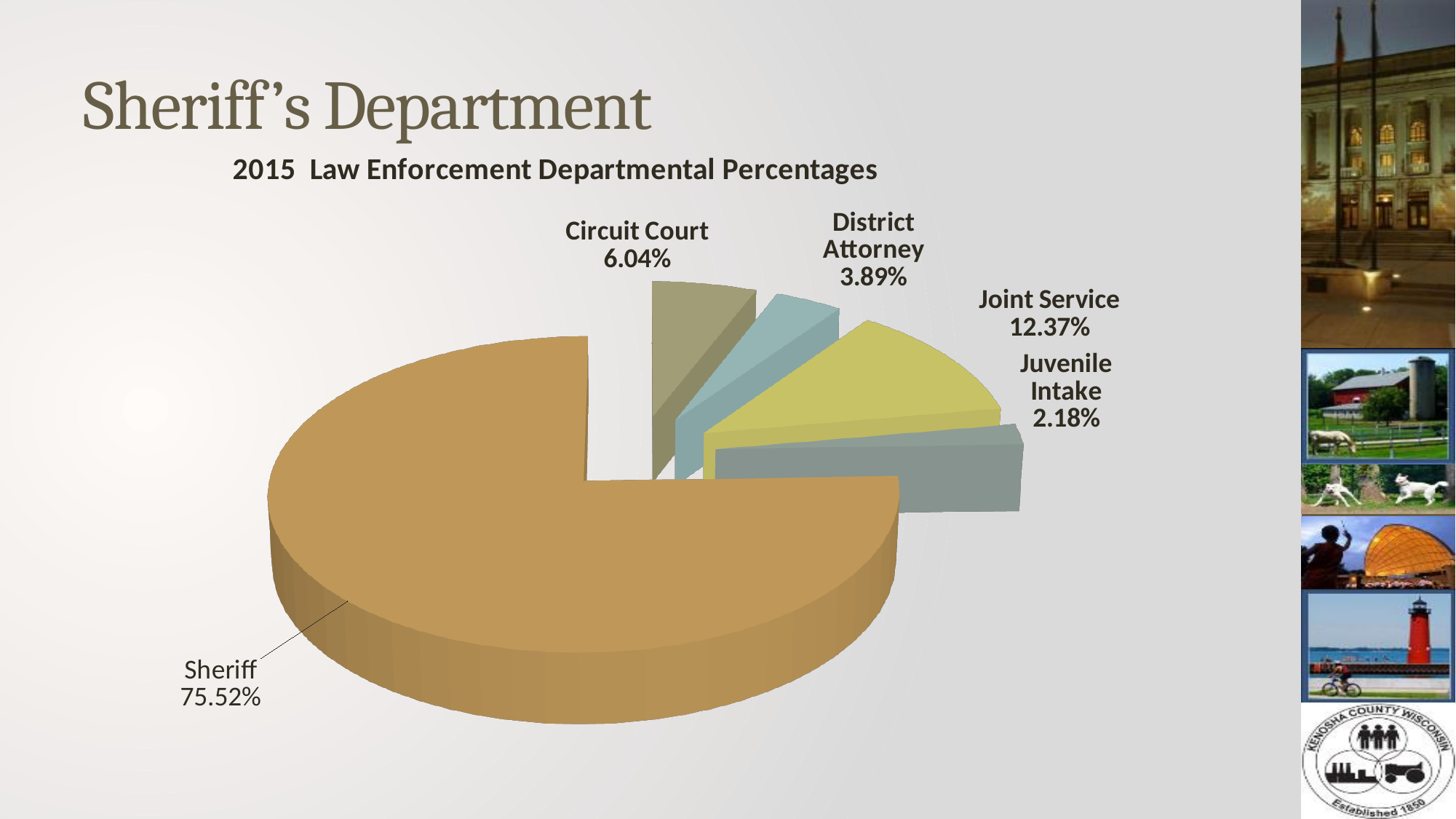
What percentage is shown for Joint Service? 12.37% What percentage is shown for Circuit Court? 6.04% Which is larger, the District Attorney share or the Circuit Court share? Circuit Court How many slices does the pie chart have? 5 What is the difference in percentage points between Joint Service and Circuit Court? 6.33 What is the title of the chart? 2015 Law Enforcement Departmental Percentages Which department has the smallest share of the pie? Juvenile Intake What percentage does the Sheriff slice represent? 75.52% What percentage is shown for District Attorney? 3.89% Which department has the largest share of the pie? Sheriff What type of chart is shown on the slide? Pie chart What percentage is shown for Juvenile Intake? 2.18%